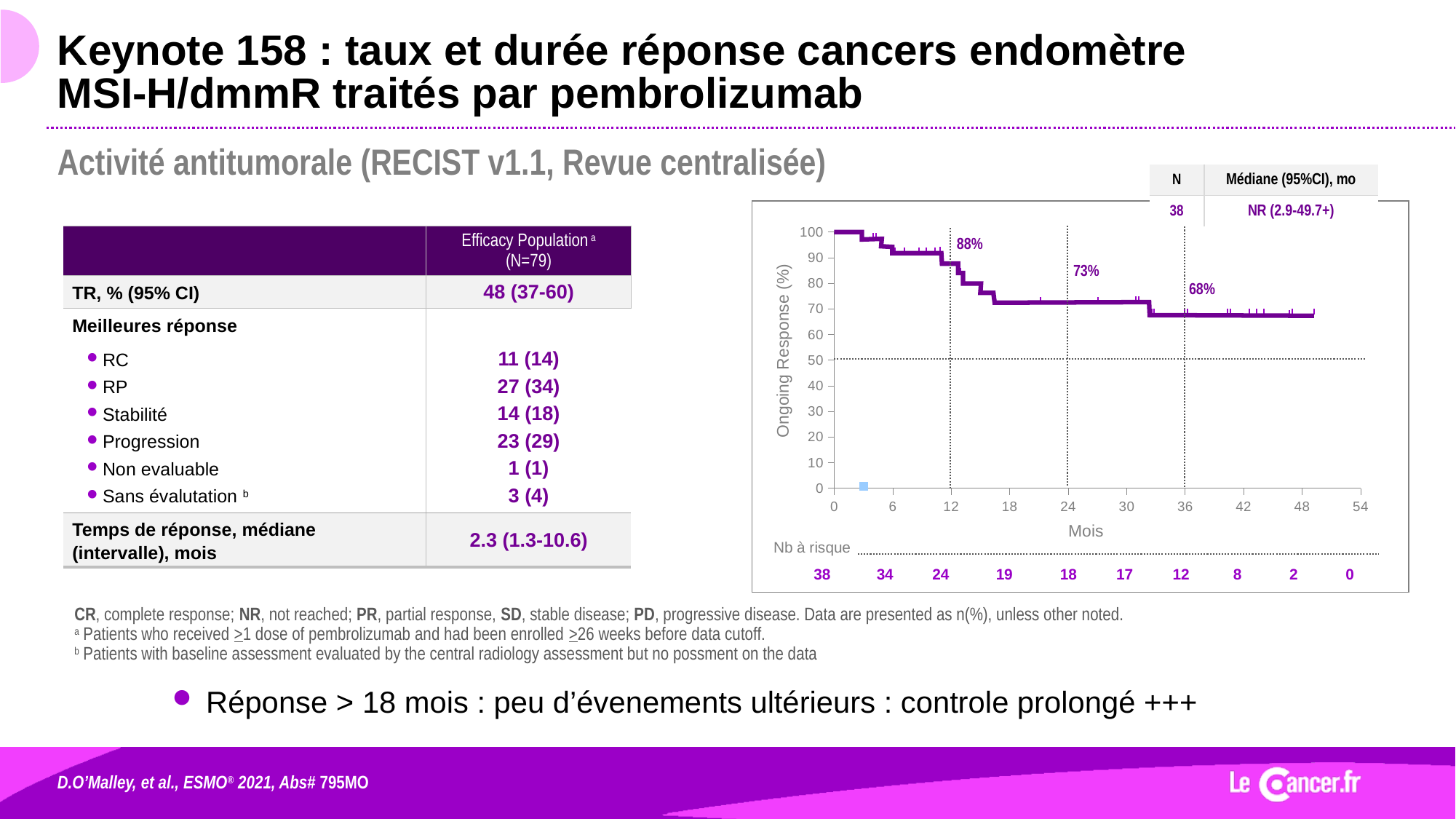
What is the ongoing response rate labelled at 24 months on the curve? 73% Is the ongoing response at 48 months greater or less than 50%? greater What is the label of the y axis of the curve? Ongoing Response (%) What is the label of the x axis of the curve? Mois How many patients are at risk at 24 months according to the number-at-risk row? 18 By how many percentage points does the labelled ongoing response drop between 12 and 36 months? 20 percentage points What is the median duration of response (95% CI) shown above the curve? NR (2.9-49.7+) Does the ongoing response curve rise or fall as months increase? Fall What is the ongoing response rate labelled at 12 months on the curve? 88% How many patients are at risk at time 0 on the curve? 38 What is the ongoing response rate labelled at 36 months on the curve? 68% What type of chart is shown on the right of the slide? Line chart (Kaplan-Meier curve)